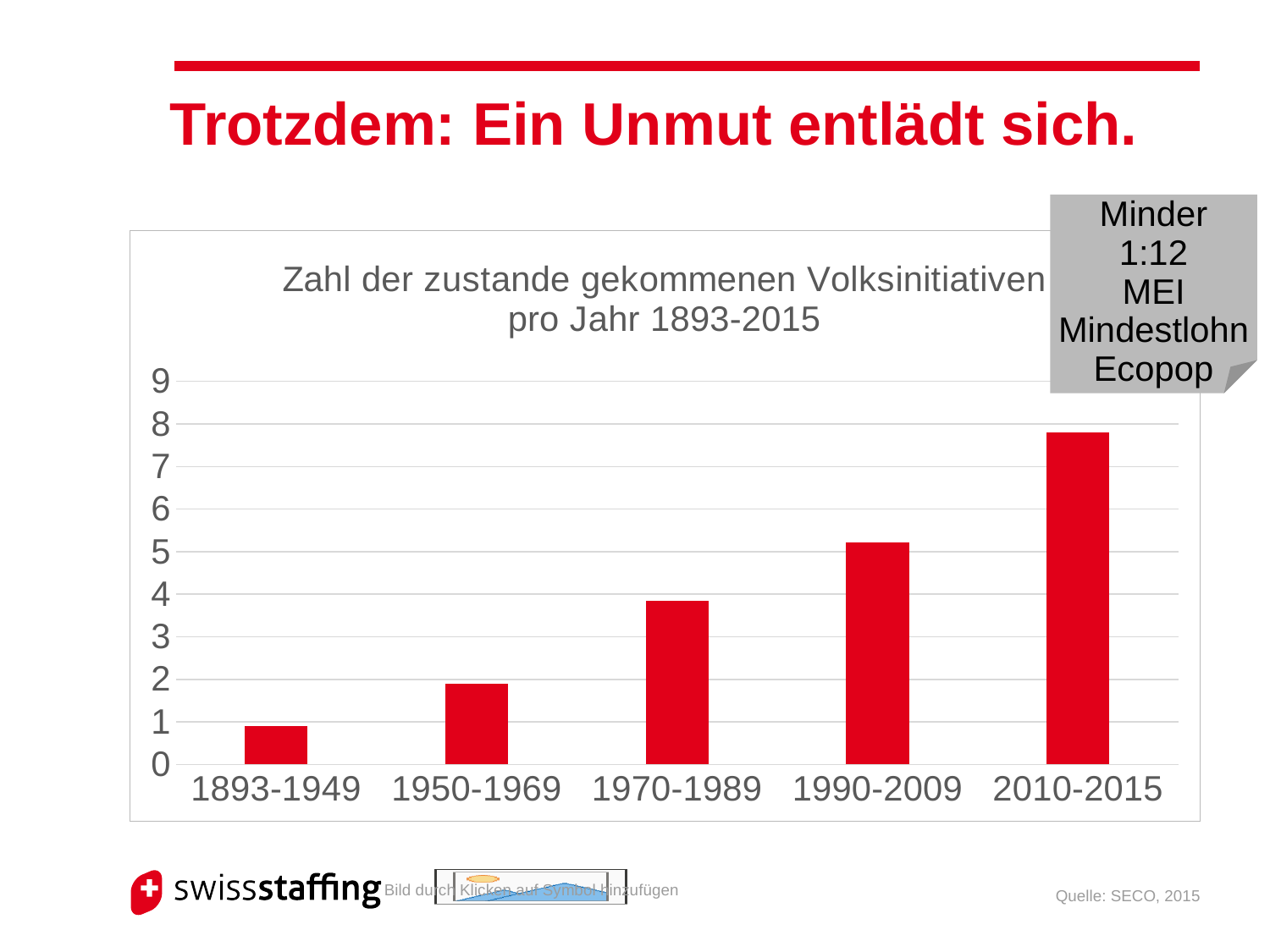
What is the title of the chart? Zahl der zustande gekommenen Volksinitiativen pro Jahr 1893-2015 What colour are the bars in the chart? red Is the value for 1970-1989 greater or less than 3? greater Is the value for 1990-2009 greater or less than 4? greater Do the values rise or fall from 1893-1949 to 2010-2015? rise How many time periods are shown on the x axis of the chart? 5 Which period has the lowest value in the chart? 1893-1949 Is the value for 1893-1949 greater or less than 2? less Which is larger, the value for 1950-1969 or the value for 1990-2009? 1990-2009 What kind of chart is shown on the slide? bar chart Which period has the highest value in the chart? 2010-2015